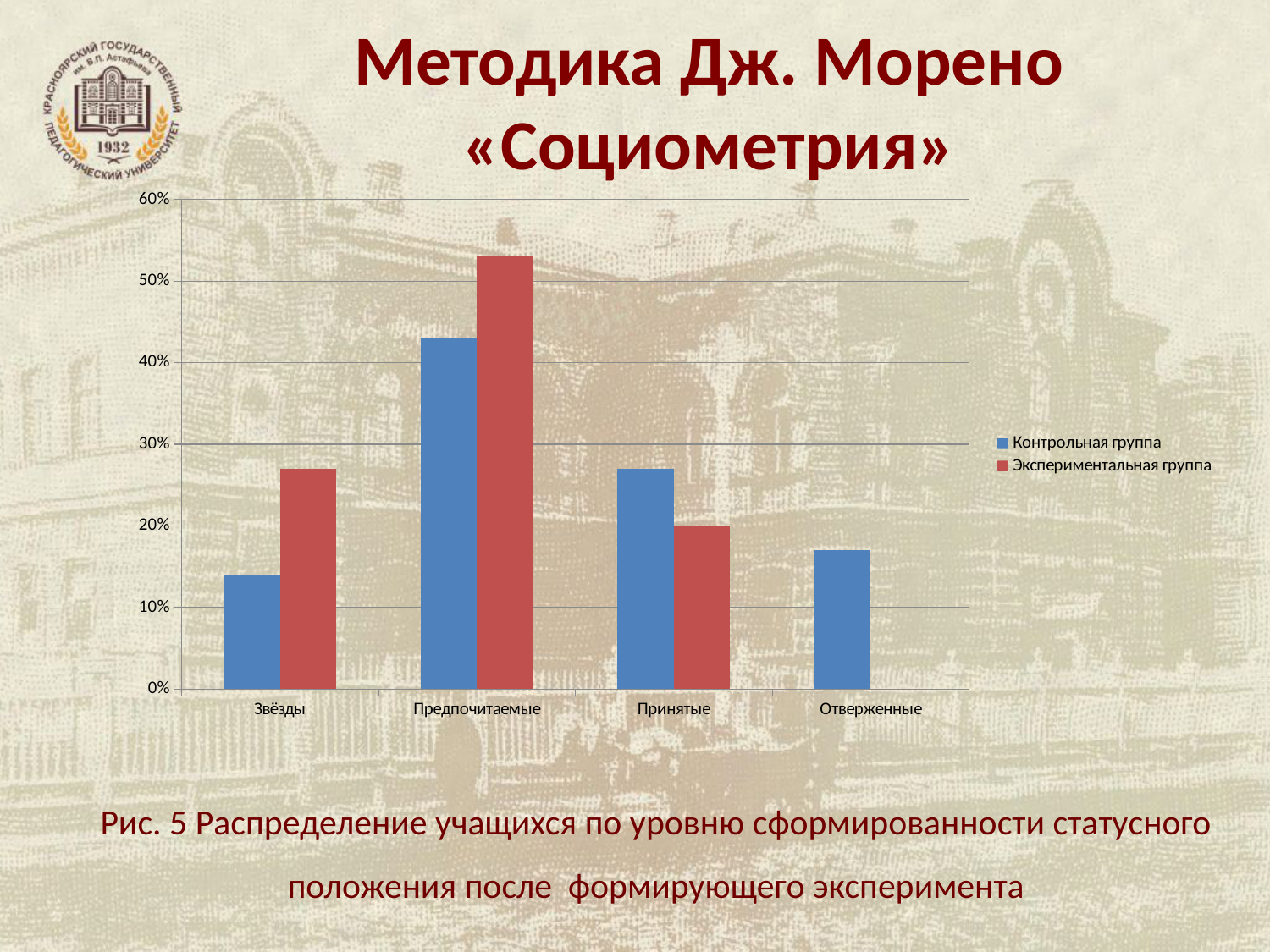
What kind of chart is shown on the slide? bar chart Is the value for Контрольная группа in the category Предпочитаемые greater or less than 40%? greater Which category has the highest value for Контрольная группа? Предпочитаемые Is the value for Контрольная группа in the category Отверженные greater or less than 20%? less How many categories are shown on the x axis? 4 How many series does the legend list? 2 Is the value for Экспериментальная группа in the category Предпочитаемые greater or less than 50%? greater For the category Звёзды, which series has the larger value: Контрольная группа or Экспериментальная группа? Экспериментальная группа Which category has the lowest value for Контрольная группа? Звёзды What colour are the bars for Экспериментальная группа? red Which category has the highest value for Экспериментальная группа? Предпочитаемые For the category Принятые, which series has the larger value: Контрольная группа or Экспериментальная группа? Контрольная группа